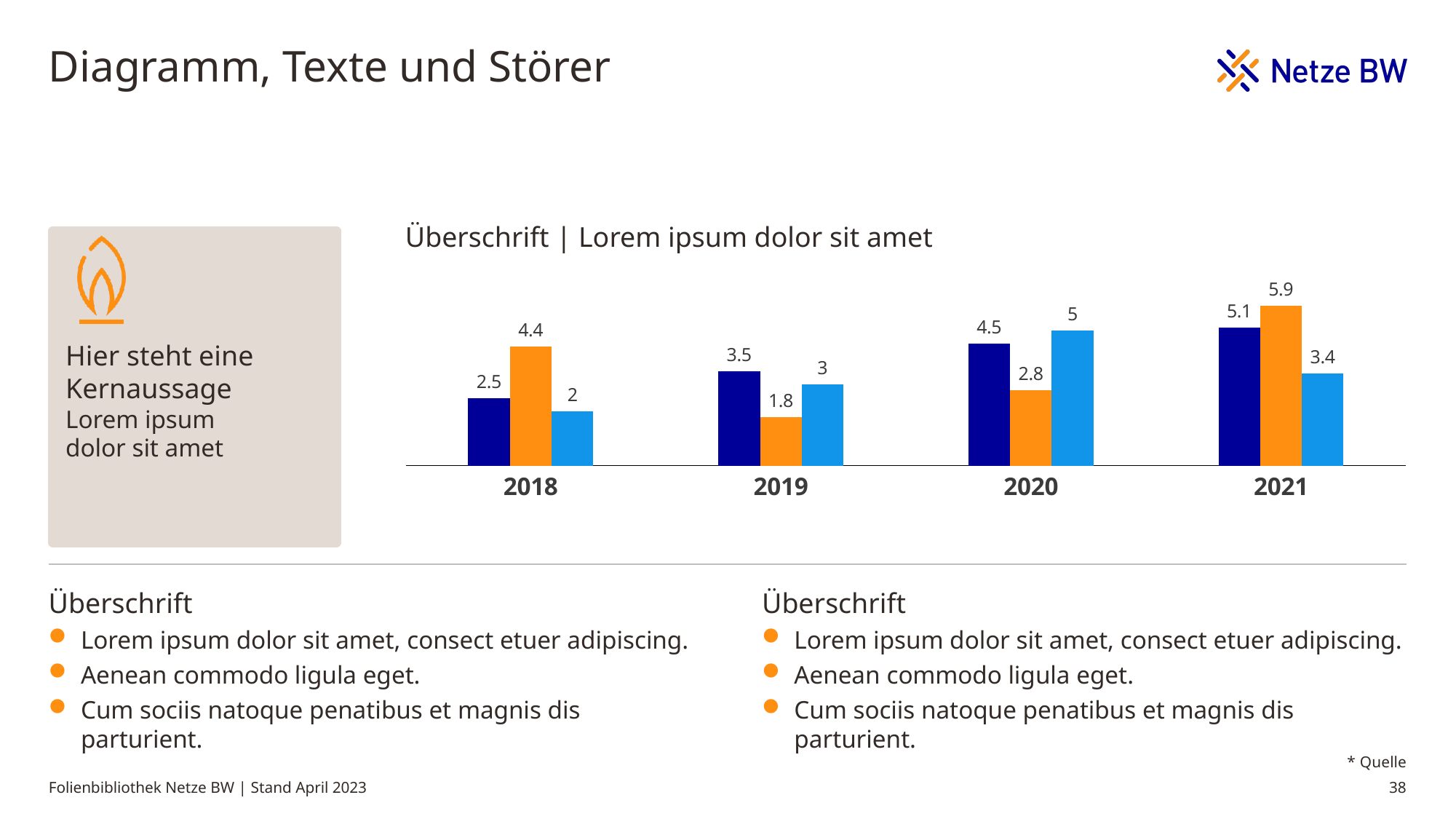
What is the difference between the orange bar and the light blue bar for 2021? 2.5 What type of chart is shown on the slide? bar chart How many bars are shown for each year in the chart? 3 What is the value of the dark blue bar for 2021? 5.1 Do the values of the dark blue bars rise or fall from 2018 to 2021? rise What is the value of the orange bar for 2019? 1.8 What is the value of the light blue bar for 2020? 5 What is the value of the orange bar for 2018? 4.4 How many years are shown on the x axis of the chart? 4 Which year has the lowest value for the orange bars? 2019 Which year has the highest value for the dark blue bars? 2021 Which is larger for 2020: the dark blue bar or the light blue bar? the light blue bar